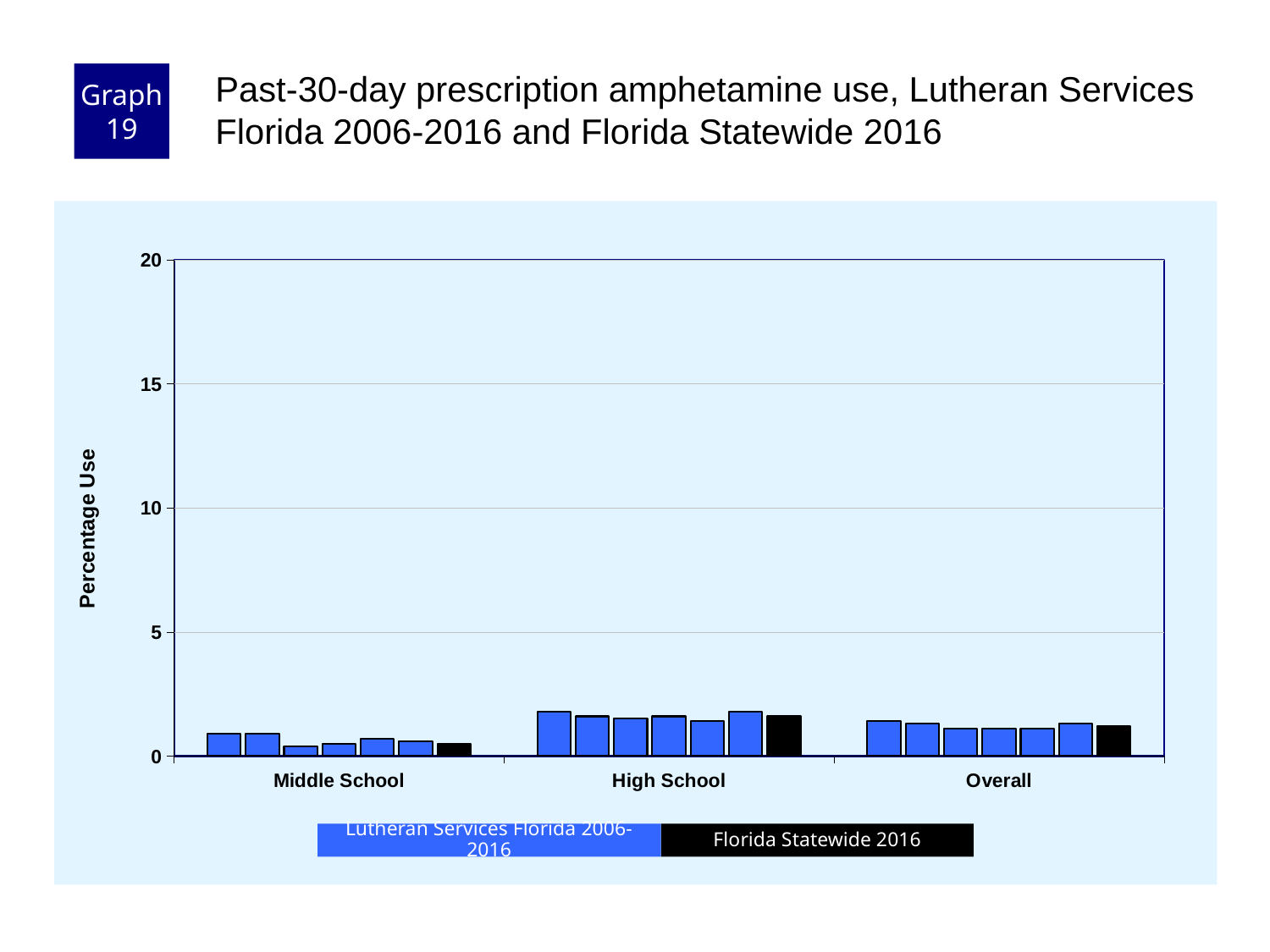
Which category has the highest Florida Statewide 2016 value? High School What kind of chart is shown on the slide? bar chart How many series does the legend list? 2 What colour are the Florida Statewide 2016 bars? black Which is larger, the Florida Statewide 2016 value for Overall or for Middle School? Overall Is the Florida Statewide 2016 value for High School greater or less than 5? less Is the Florida Statewide 2016 value for Overall greater or less than 5? less What is the label on the y axis? Percentage Use Which is larger, the Florida Statewide 2016 value for High School or for Middle School? High School Which category has the lowest Florida Statewide 2016 value? Middle School Is the Florida Statewide 2016 value for Middle School greater or less than 5? less How many categories are shown on the x axis? 3